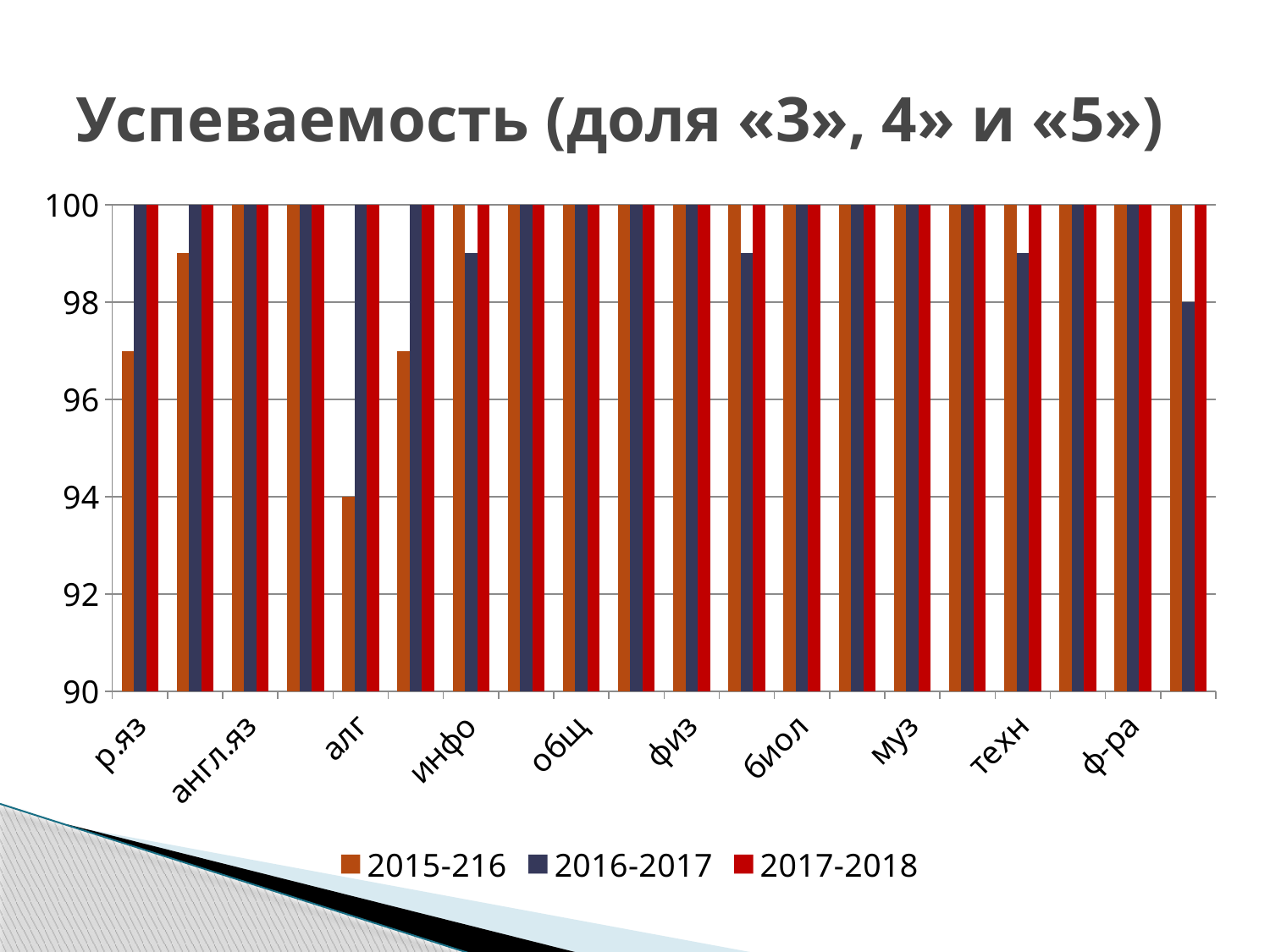
What are the three series listed in the legend? 2015-216, 2016-2017, 2017-2018 What is the title of the chart? Успеваемость (доля «3», 4» и «5») What is the value for алг in the 2015-216 series? 94 How many series does the legend list? 3 Is the value for инфо in the 2016-2017 series greater or less than 98? greater For алг, which is larger: the 2015-216 value or the 2016-2017 value? 2016-2017 Which category has the lowest value in the 2015-216 series? алг What is the value for р.яз in the 2016-2017 series? 100 What is the value for англ.яз in the 2017-2018 series? 100 Is the value for р.яз in the 2015-216 series greater or less than 98? less What kind of chart is shown on the slide? bar chart For алг, what is the difference between the 2017-2018 value and the 2015-216 value? 6